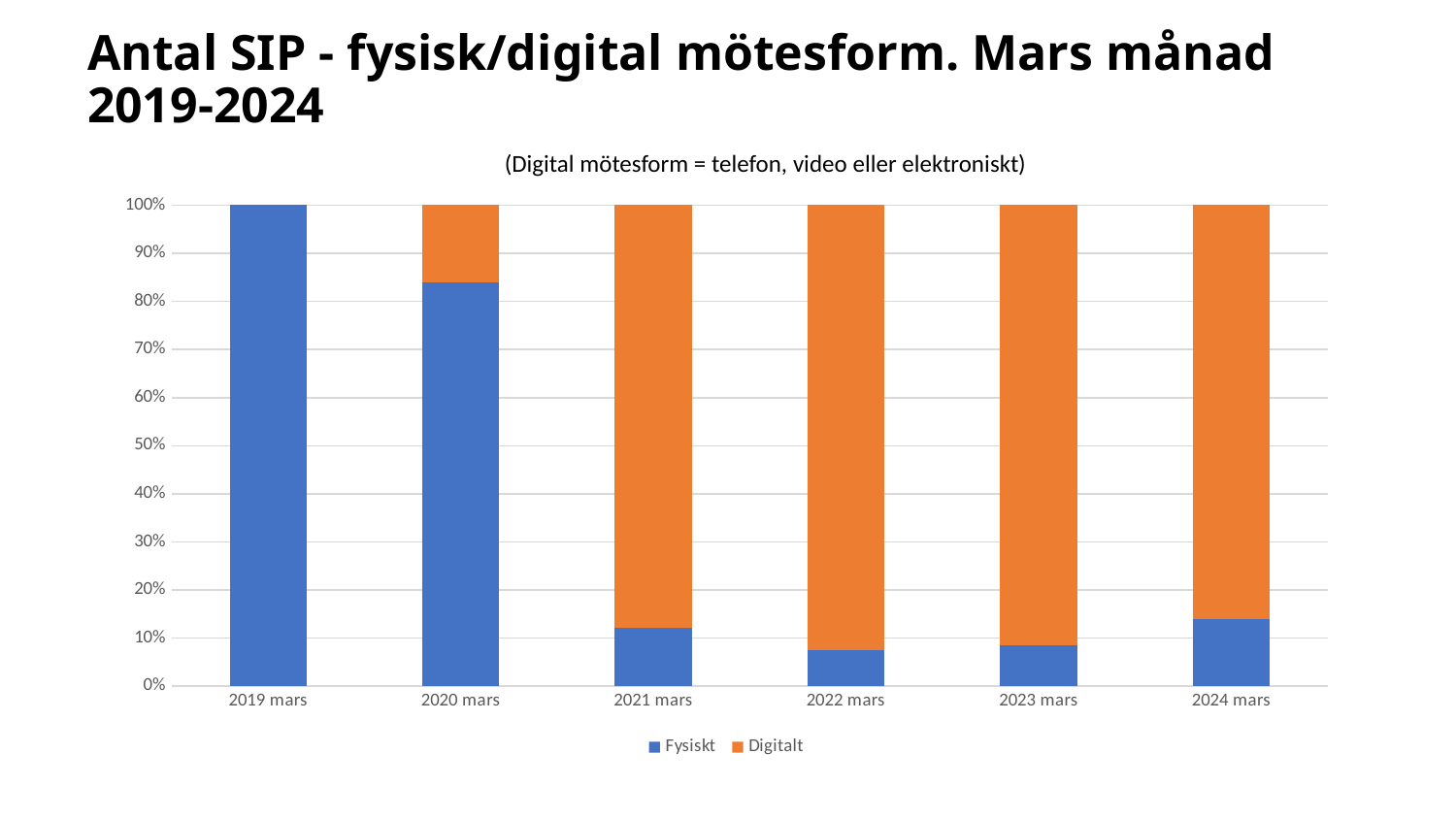
Is the Fysiskt share for 2022 mars greater or less than 10%? less What is the Fysiskt share for 2019 mars? 100% Does the Fysiskt share rise or fall from 2019 mars to 2022 mars? fall Which series is shown in orange? Digitalt Is the Fysiskt share for 2020 mars greater or less than 80%? greater Is the Fysiskt share for 2021 mars greater or less than 20%? less How many series does the legend list? 2 How many categories are shown on the x axis? 6 Which category has the highest Fysiskt share? 2019 mars What kind of chart is shown on the slide? bar chart Which is larger, the Fysiskt share for 2020 mars or for 2021 mars? 2020 mars Which category has the lowest Digitalt share? 2019 mars